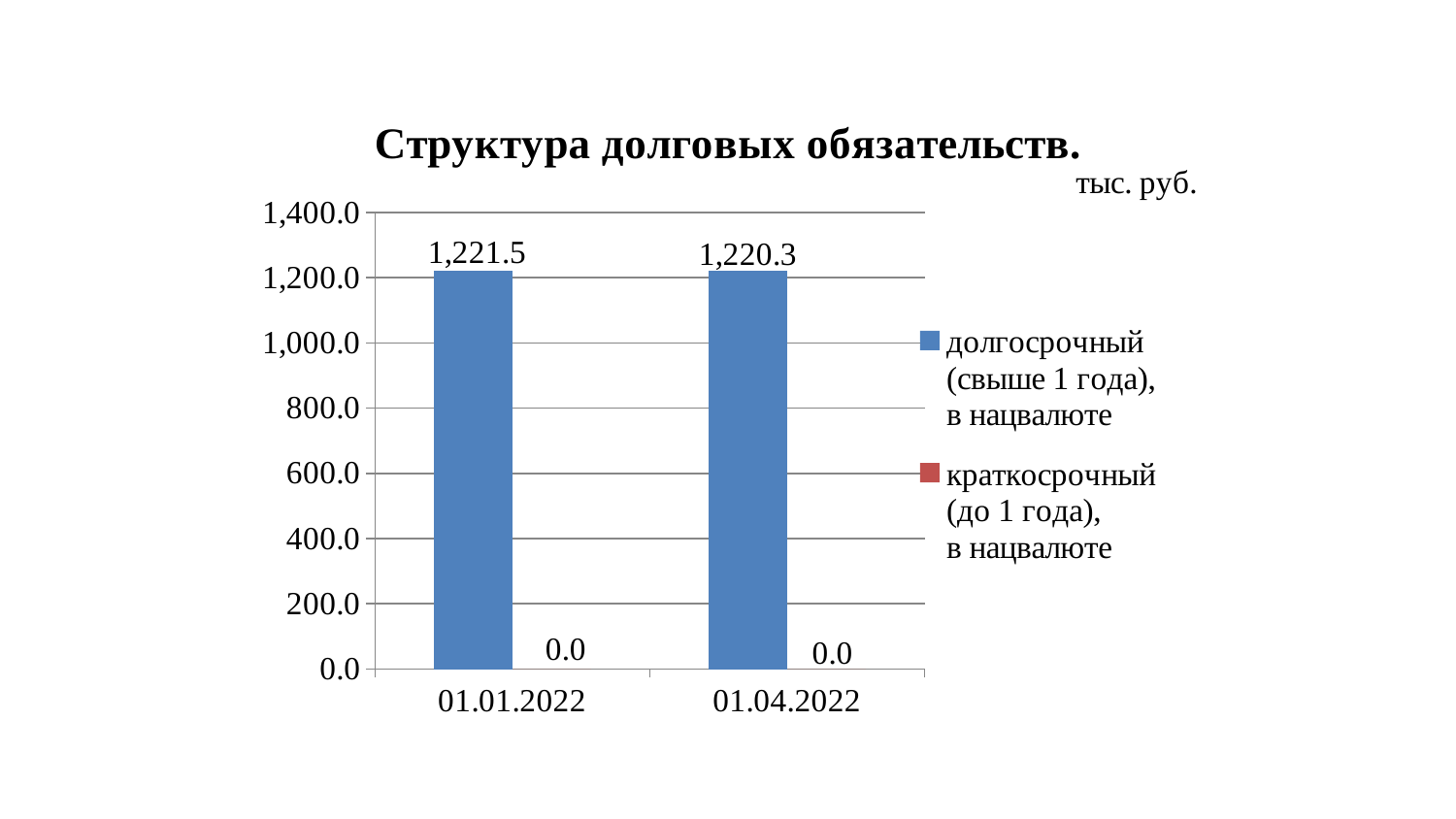
Which date has the higher долгосрочный (свыше 1 года) value, 01.01.2022 or 01.04.2022? 01.01.2022 What is the value of the долгосрочный (свыше 1 года), в нацвалюте series for 01.01.2022? 1,221.5 What is the title of the chart? Структура долговых обязательств. What is the value of the долгосрочный (свыше 1 года), в нацвалюте series for 01.04.2022? 1,220.3 What is the value of the краткосрочный (до 1 года), в нацвалюте series for 01.01.2022? 0.0 Is the долгосрочный value for 01.04.2022 greater or less than 1,000.0? greater How many dates (categories) are shown on the x axis? 2 What kind of chart is shown on the slide? bar chart How many series does the legend list? 2 By how much does the долгосрочный value for 01.01.2022 exceed the value for 01.04.2022? 1.2 What is the value of the краткосрочный (до 1 года), в нацвалюте series for 01.04.2022? 0.0 Does the долгосрочный (свыше 1 года) value rise or fall from 01.01.2022 to 01.04.2022? fall